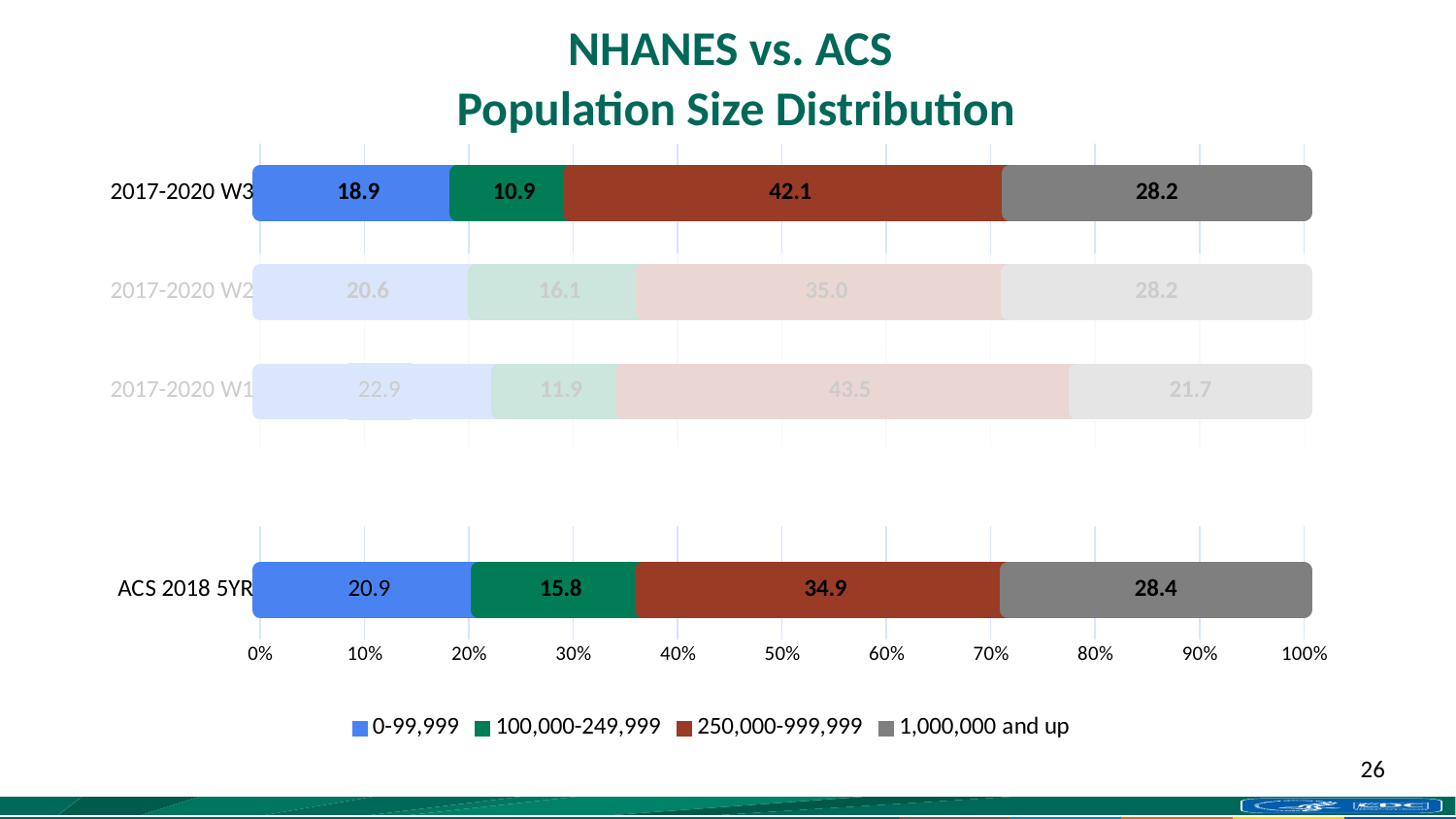
What is the title of the chart? NHANES vs. ACS Population Size Distribution What is the difference between the 250,000-999,999 values for 2017-2020 W3 and ACS 2018 5YR? 7.2 Which category has the highest value for the 250,000-999,999 series? 2017-2020 W1 What kind of chart is shown on the slide? Stacked bar chart What is the value of the 100,000-249,999 segment for 2017-2020 W2? 16.1 What is the value of the 250,000-999,999 segment for 2017-2020 W3? 42.1 Which category has the lowest value for the 100,000-249,999 series? 2017-2020 W3 What is the value of the 1,000,000 and up segment for 2017-2020 W1? 21.7 Which is larger: the 0-99,999 value for 2017-2020 W1 or for ACS 2018 5YR? 2017-2020 W1 What is the value of the 0-99,999 segment for ACS 2018 5YR? 20.9 How many series does the legend list? 4 How many bars (categories) are plotted in the chart? 4